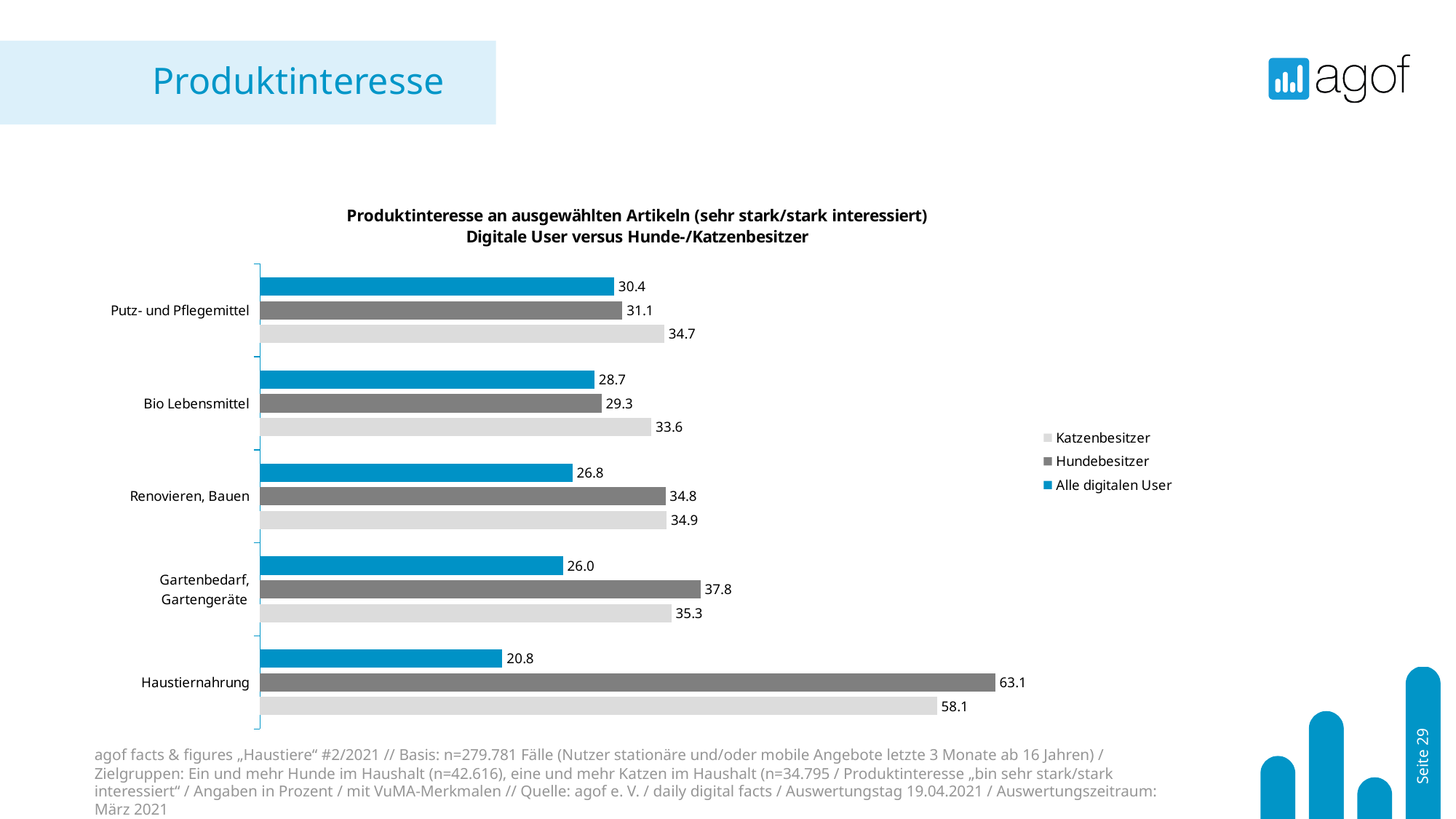
What is the value for Hundebesitzer in the Haustiernahrung category? 63.1 What is the value for Katzenbesitzer in the Gartenbedarf, Gartengeräte category? 35.3 How many series does the legend list? 3 Which category has the lowest value for Alle digitalen User? Haustiernahrung What is the difference between the Hundebesitzer and Katzenbesitzer values for Haustiernahrung? 5.0 Which category has the highest value for Katzenbesitzer? Haustiernahrung How many product categories are shown on the chart? 5 For Renovieren, Bauen, which is larger: the value for Hundebesitzer or for Alle digitalen User? Hundebesitzer What is the difference between the Hundebesitzer and Alle digitalen User values for Gartenbedarf, Gartengeräte? 11.8 What is the value for Alle digitalen User in the Bio Lebensmittel category? 28.7 What kind of chart is shown on the slide? Bar chart Which series is shown in blue in the legend? Alle digitalen User